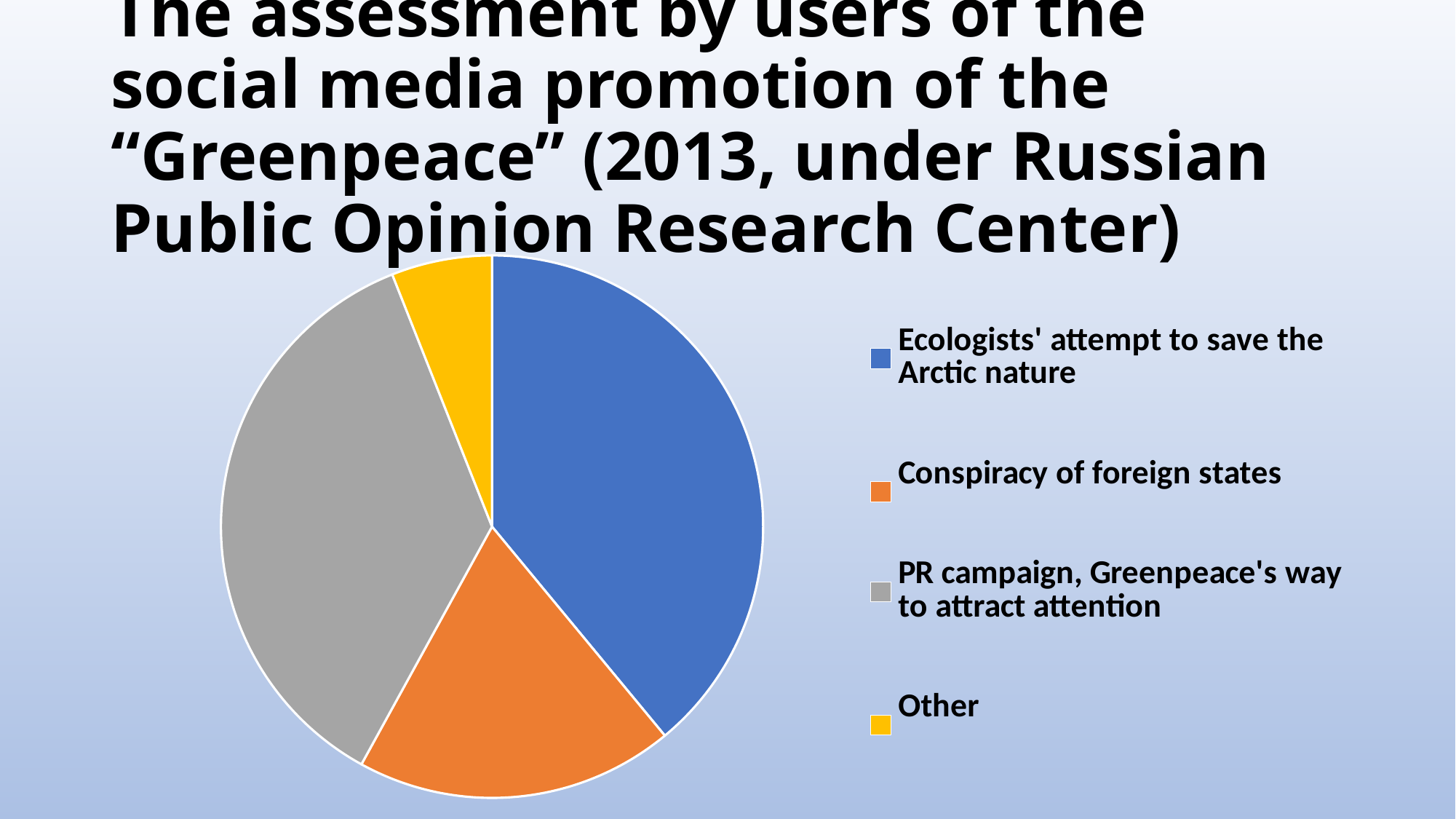
Which category has the smallest slice in the pie chart? Other Which slice is larger: "PR campaign, Greenpeace's way to attract attention" or "Other"? PR campaign, Greenpeace's way to attract attention What kind of chart is shown on the slide? pie chart Which category is represented by the grey slice in the pie chart? PR campaign, Greenpeace's way to attract attention Which slice is larger: "PR campaign, Greenpeace's way to attract attention" or "Conspiracy of foreign states"? PR campaign, Greenpeace's way to attract attention How many slices does the pie chart have? 4 How many entries does the legend of the pie chart list? 4 Which slice is larger: "Ecologists' attempt to save the Arctic nature" or "Conspiracy of foreign states"? Ecologists' attempt to save the Arctic nature What colour is the slice for "Conspiracy of foreign states" in the pie chart? orange